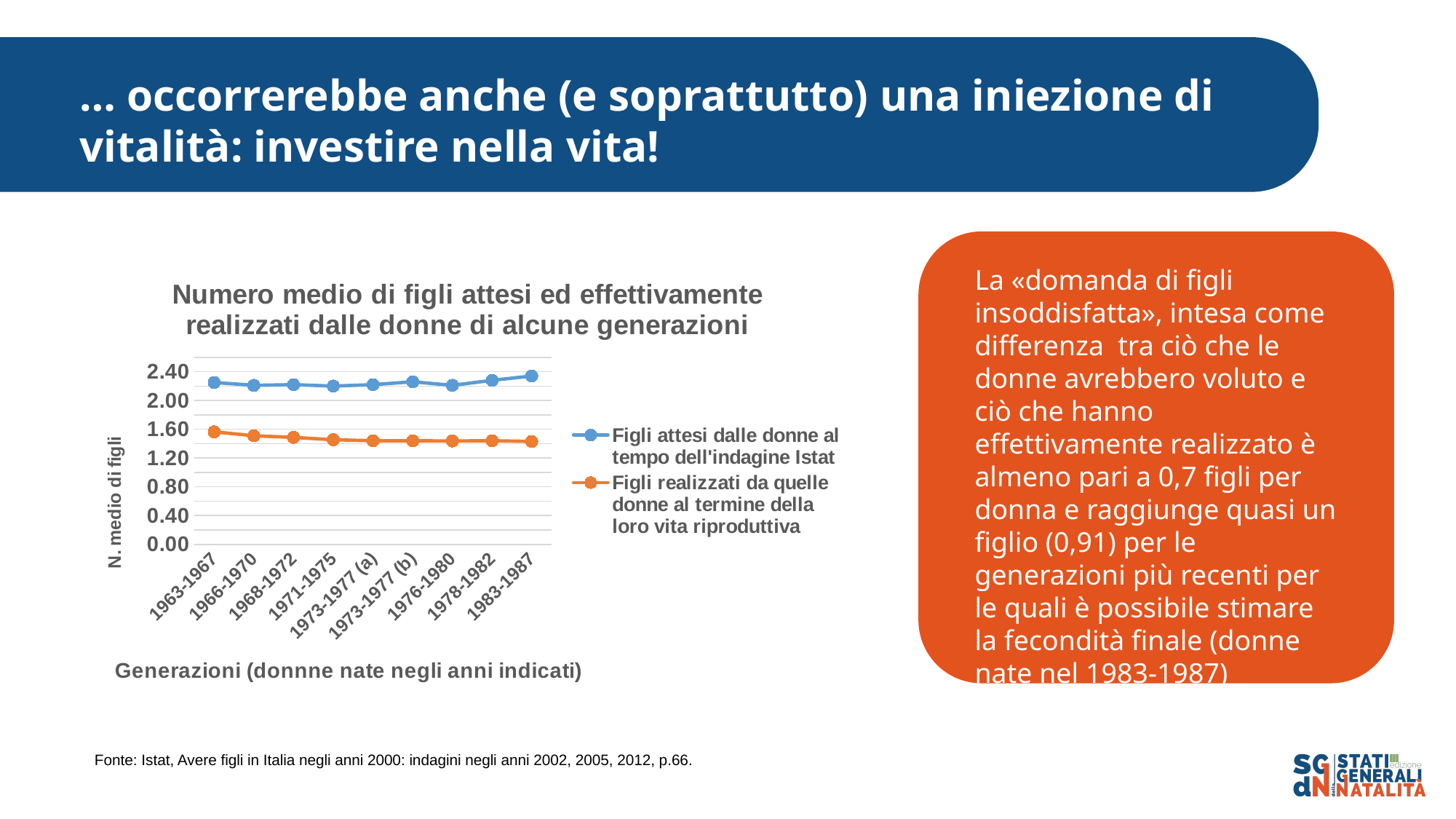
What is the label of the chart's y axis? N. medio di figli What kind of chart is shown on the slide? line chart What is the title of the chart? Numero medio di figli attesi ed effettivamente realizzati dalle donne di alcune generazioni Which generation has the highest value for 'Figli attesi dalle donne al tempo dell'indagine Istat'? 1983-1987 Is the value of 'Figli attesi dalle donne al tempo dell'indagine Istat' for the 1983-1987 generation greater or less than 2.00? greater Which generation has the highest value for 'Figli realizzati da quelle donne al termine della loro vita riproduttiva'? 1963-1967 How many generation categories are plotted along the x axis? 9 How many series does the chart's legend list? 2 For the 1971-1975 generation, which series has the larger value: 'Figli attesi' or 'Figli realizzati'? Figli attesi Is the value of 'Figli realizzati da quelle donne al termine della loro vita riproduttiva' for the 1983-1987 generation greater or less than 1.20? greater Does the 'Figli realizzati' series rise or fall from the 1963-1967 generation to the 1983-1987 generation? fall Is the value of 'Figli realizzati da quelle donne al termine della loro vita riproduttiva' for the 1963-1967 generation greater or less than 2.00? less